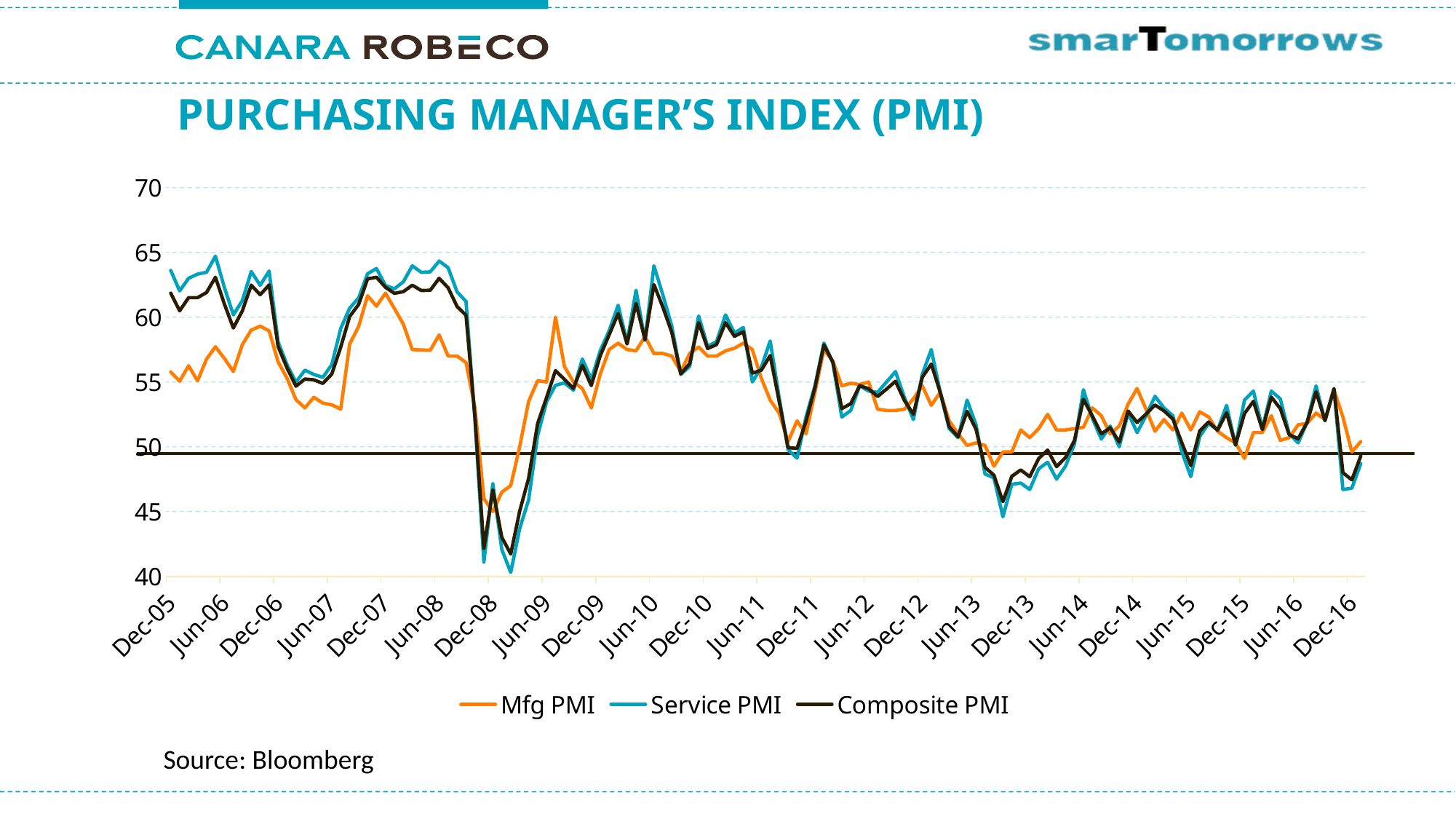
What is the title of the chart? PURCHASING MANAGER'S INDEX (PMI) Is the value of Mfg PMI at Dec-05 greater or less than 50? greater Is the value of Mfg PMI at Jun-10 greater or less than 55? greater Is the value of Composite PMI at Dec-16 greater or less than 50? less What kind of chart is shown on the slide? Line chart Does the Service PMI line rise or fall between Jun-10 and Dec-11? Fall Does the Mfg PMI line rise or fall between Dec-08 and Jun-09? Rise Which series reaches the lowest point on the chart? Service PMI How many series does the legend list? 3